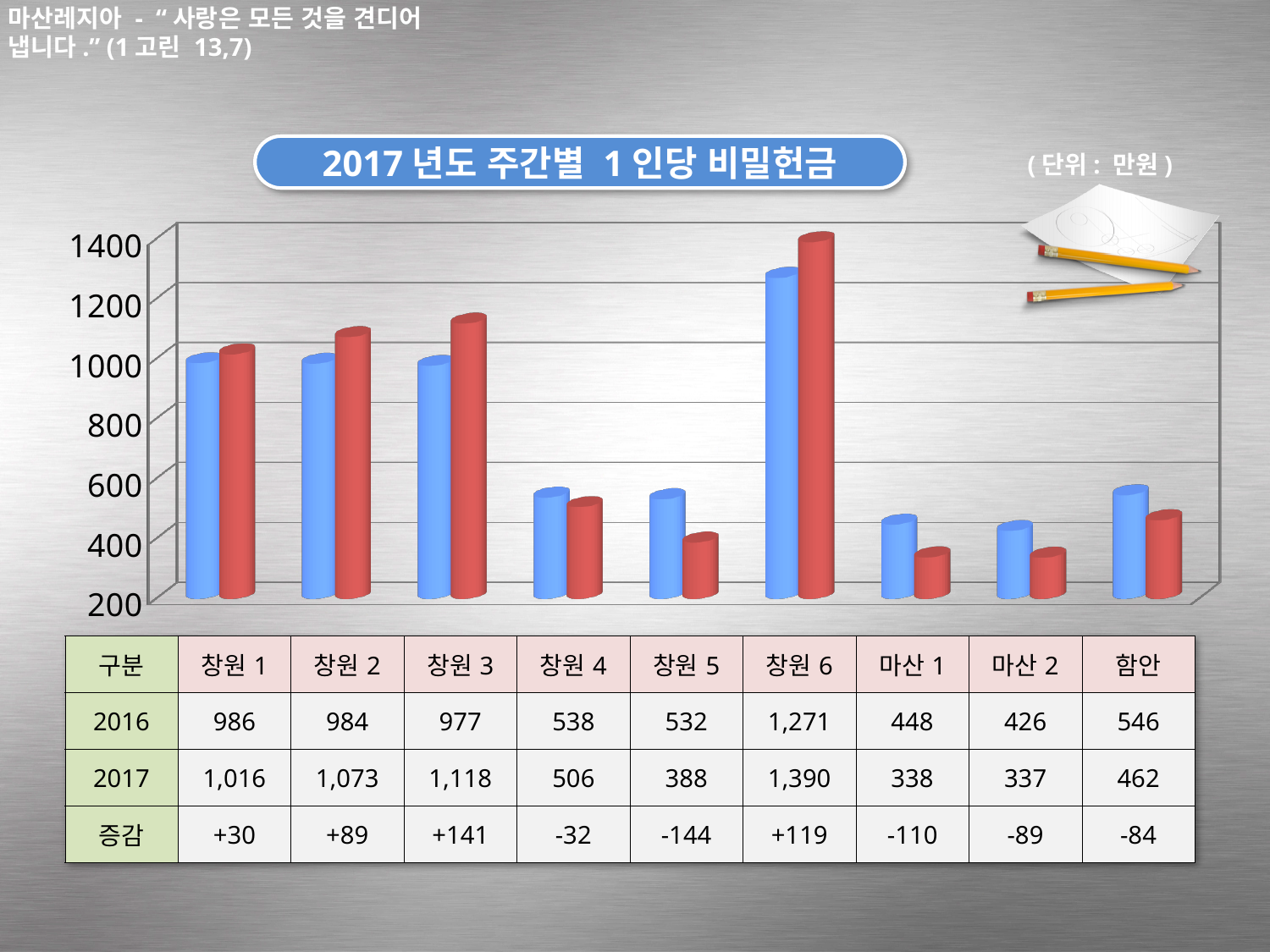
Is the 2017 value for 창원 6 greater or less than 1200? greater How many categories are plotted on the x axis of the chart? 9 What is the title of the chart? 2017 년도 주간별 1 인당 비밀헌금 What is the 2017 value for 창원 3? 1,118 Which category has the lowest 2017 value? 마산 2 Which is larger for 함안, the 2016 value or the 2017 value? 2016 What unit is stated for the chart values? 만원 What is the difference between the 2017 and 2016 values for 창원 5? -144 What kind of chart is shown on the slide? bar chart Which category has the lowest 2016 value? 마산 2 What is the 2016 value for 마산 2? 426 Which category has the highest 2017 value? 창원 6